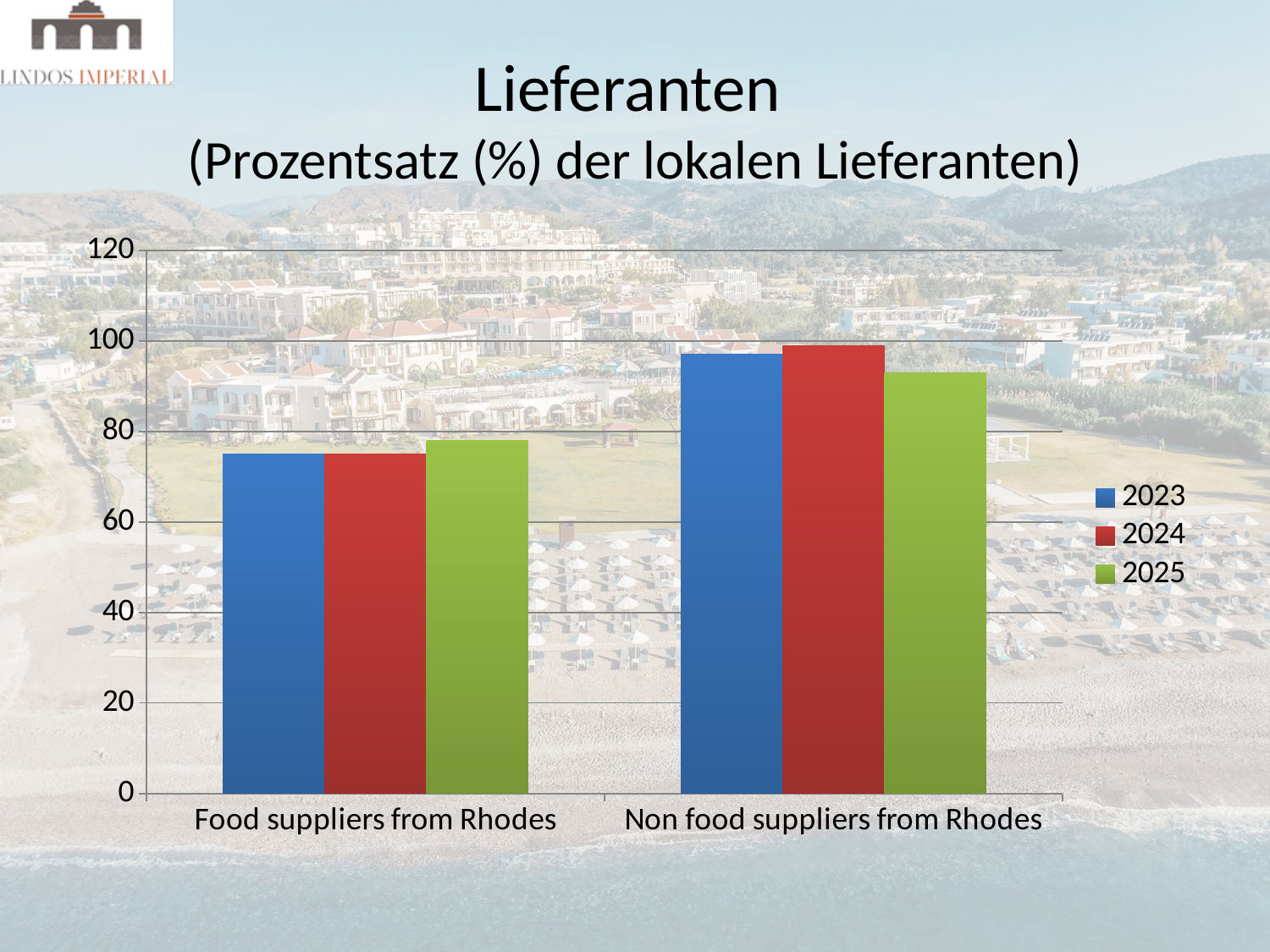
What kind of chart is shown on the slide? bar chart Is the 2025 value for Food suppliers from Rhodes greater or less than 60? greater How many categories are shown on the x axis? 2 What is the title of the chart? Lieferanten (Prozentsatz (%) der lokalen Lieferanten) Is the 2025 value for Non food suppliers from Rhodes greater or less than 100? less Is the 2023 value for Non food suppliers from Rhodes greater or less than 80? greater For Non food suppliers from Rhodes, which is larger: the 2024 value or the 2025 value? 2024 For 2023, which category has the larger value: Food suppliers from Rhodes or Non food suppliers from Rhodes? Non food suppliers from Rhodes How many series does the legend list? 3 Which years are listed in the legend? 2023, 2024, 2025 For Non food suppliers from Rhodes, which year has the lowest value? 2025